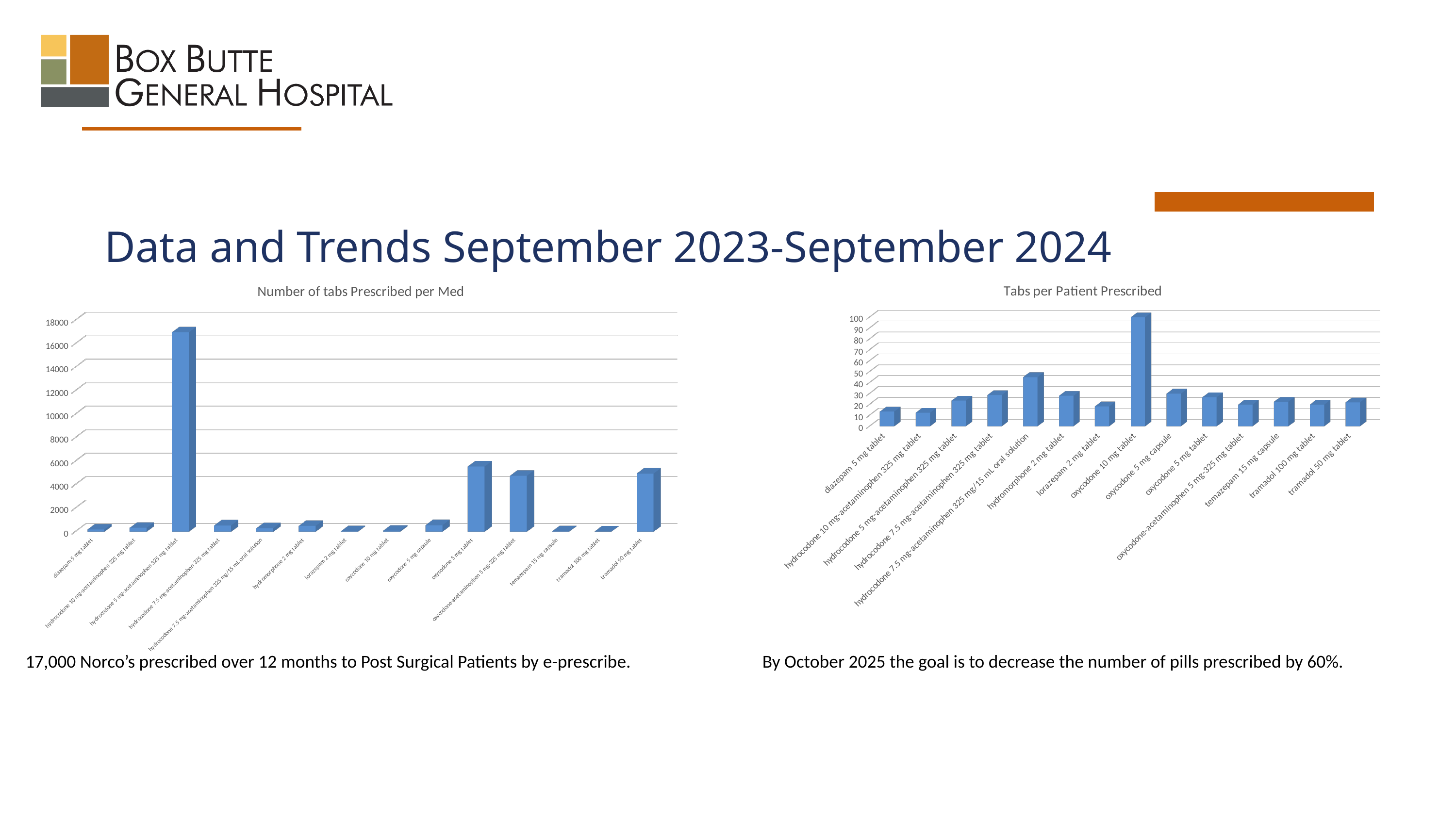
In the left chart "Number of tabs Prescribed per Med", which is larger: the value for oxycodone 5 mg tablet or the value for temazepam 15 mg capsule? oxycodone 5 mg tablet In the left chart "Number of tabs Prescribed per Med", is the value for hydrocodone 5 mg-acetaminophen 325 mg tablet greater or less than 14000? greater In the left chart "Number of tabs Prescribed per Med", is the value for lorazepam 2 mg tablet greater or less than 2000? less In the right chart "Tabs per Patient Prescribed", which medication has the highest tabs per patient? oxycodone 10 mg tablet In the right chart "Tabs per Patient Prescribed", is the value for oxycodone 10 mg tablet greater or less than 80? greater What is the title of the right chart on the slide? Tabs per Patient Prescribed What type of chart is the left chart titled "Number of tabs Prescribed per Med"? Bar chart In the left chart "Number of tabs Prescribed per Med", which medication has the highest number of tabs prescribed? hydrocodone 5 mg-acetaminophen 325 mg tablet How many medication categories are shown in the left chart "Number of tabs Prescribed per Med"? 14 In the right chart "Tabs per Patient Prescribed", which is larger: the value for oxycodone 10 mg tablet or the value for lorazepam 2 mg tablet? oxycodone 10 mg tablet